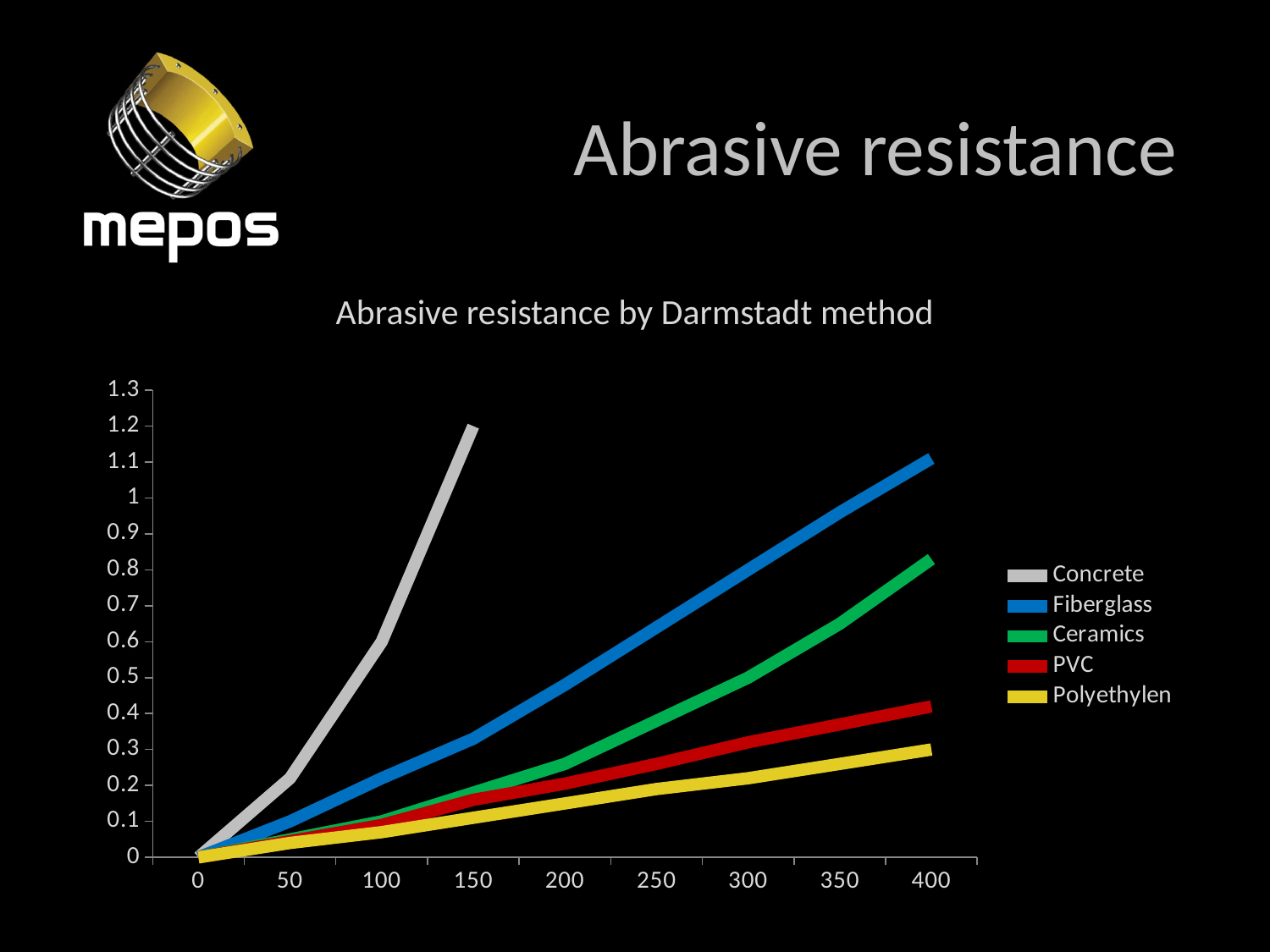
At x = 400, which is larger, Fiberglass or Ceramics? Fiberglass How many series does the legend list? 5 Do the values for Fiberglass rise or fall as x increases from 0 to 400? rise Is the value for Polyethylen at x = 400 greater or less than 0.4? less Is the value for Concrete at x = 150 greater or less than 1? greater What is the title of the chart? Abrasive resistance by Darmstadt method What kind of chart is shown on the slide? line chart At x = 400, which is larger, PVC or Polyethylen? PVC Which series reaches the highest value on the chart? Concrete What colour is the Concrete line in the legend? grey Which series has the lowest value at x = 400? Polyethylen Which series has the highest value at x = 400? Fiberglass